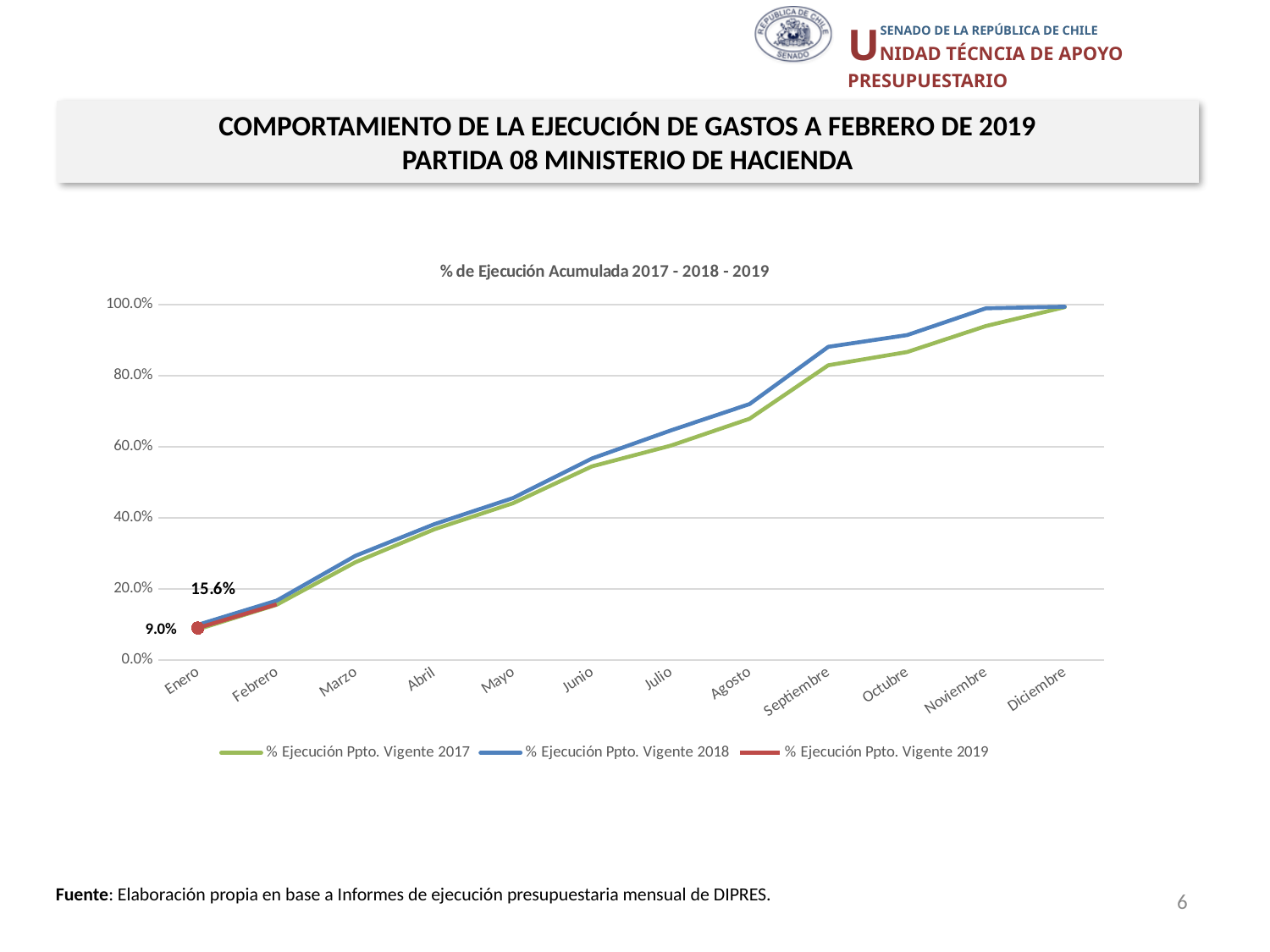
By how many percentage points did % Ejecución Ppto. Vigente 2019 increase from Enero to Febrero? 6.6% What is the value of % Ejecución Ppto. Vigente 2019 for Febrero? 15.6% In Septiembre, which series has the higher value: % Ejecución Ppto. Vigente 2017 or % Ejecución Ppto. Vigente 2018? % Ejecución Ppto. Vigente 2018 Is the value for % Ejecución Ppto. Vigente 2017 in Junio greater or less than 60.0%? less What is the value of % Ejecución Ppto. Vigente 2019 for Enero? 9.0% How many months are shown along the x axis of the chart? 12 What colour is the line for % Ejecución Ppto. Vigente 2019? red What kind of chart is shown on the slide? line chart How many series does the chart legend list? 3 What is the title of the chart? % de Ejecución Acumulada 2017 - 2018 - 2019 Is the value for % Ejecución Ppto. Vigente 2018 in Agosto greater or less than 60.0%? greater Do the values of % Ejecución Ppto. Vigente 2018 rise or fall from Enero to Diciembre? rise